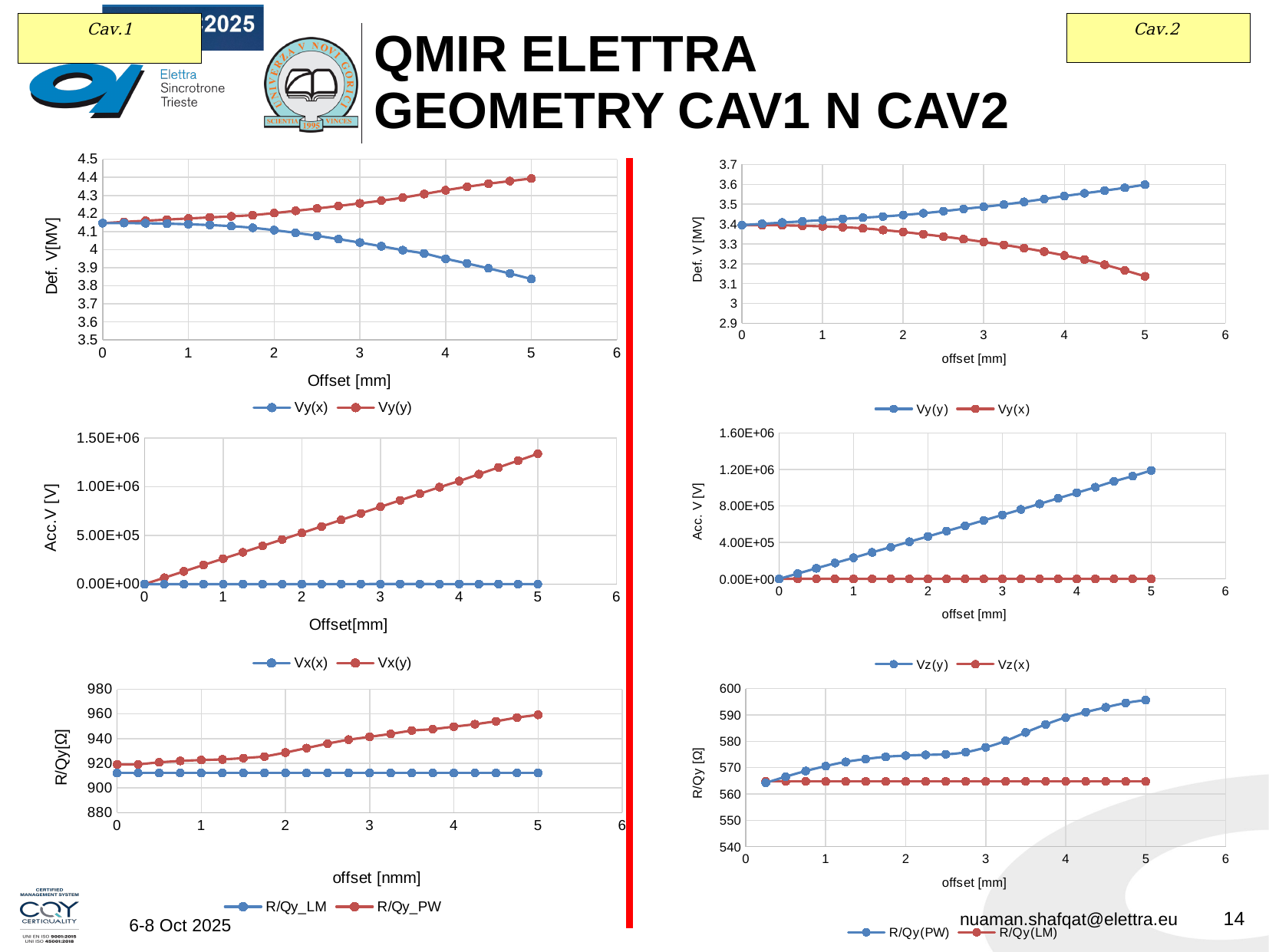
On the top-left chart (Def. V[MV] vs Offset [mm]), does the Vy(y) series rise or fall as the offset increases? rise On the top-right chart (Def. V [MV] vs offset [mm]), is the Vy(x) value at offset 5 mm greater or less than 3.2? less On the top-left chart (Def. V[MV] vs Offset [mm]), does the Vy(x) series rise or fall as the offset increases? fall On the top-left chart (Def. V[MV] vs Offset [mm]), how many series does the legend list? 2 What type of chart is the bottom-right chart (R/Qy [Ω] vs offset [mm])? line chart On the bottom-right chart (R/Qy [Ω] vs offset [mm]), is the R/Qy(PW) value at offset 5 mm greater or less than 590? greater On the middle-right chart (Acc. V [V] vs offset [mm]), does the Vz(y) series rise or fall as the offset increases? rise On the middle-left chart (Acc.V [V] vs Offset[mm]), which series is higher at offset 5 mm, Vx(x) or Vx(y)? Vx(y) On the bottom-left chart (R/Qy[Ω] vs offset), is the R/Qy_PW value at offset 5 mm greater or less than 940? greater On the bottom-left chart (R/Qy[Ω] vs offset), which series is higher at offset 5 mm, R/Qy_LM or R/Qy_PW? R/Qy_PW